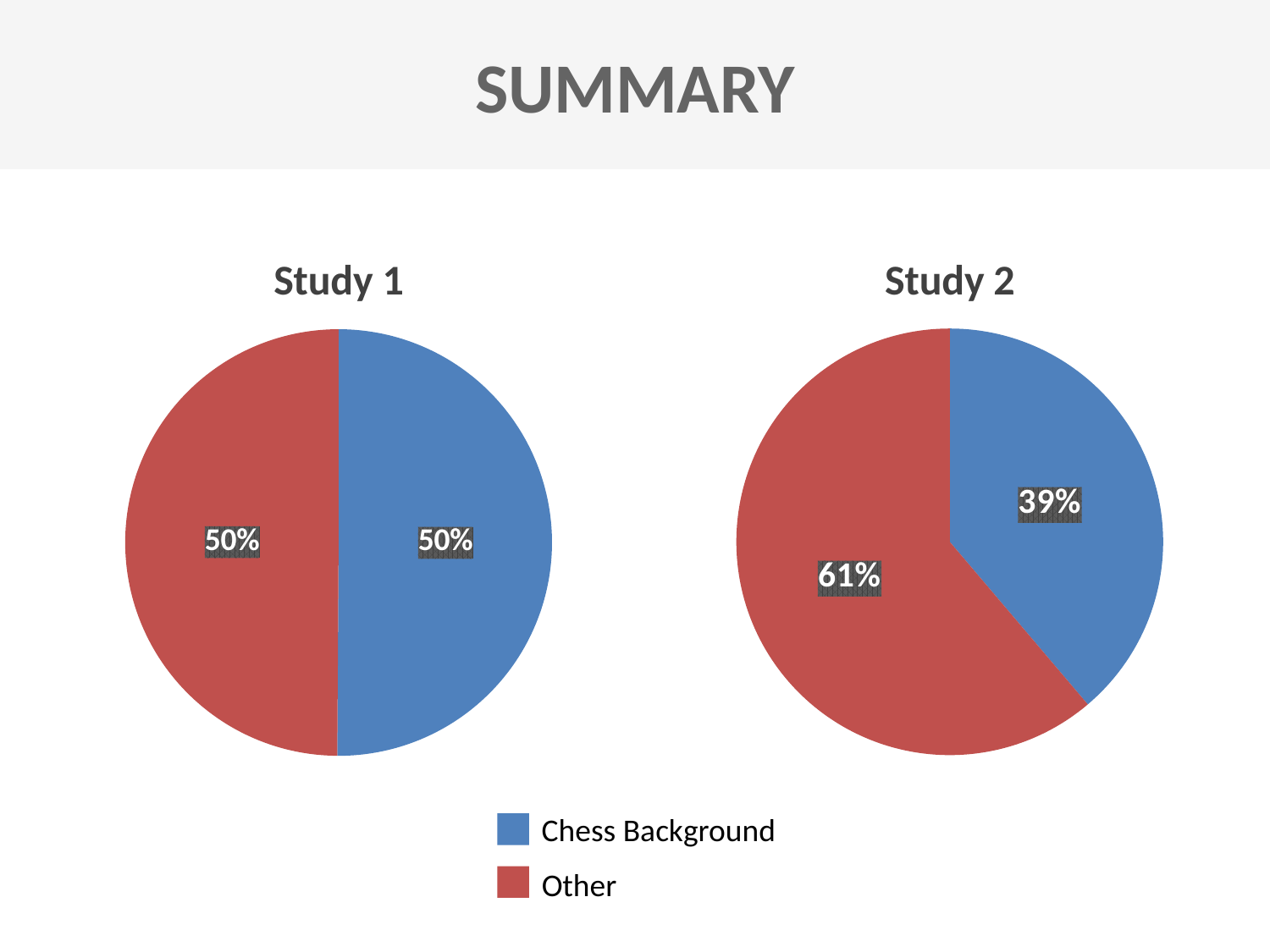
In the Study 2 chart, which slice is the smallest? Chess Background In the Study 2 chart, what is the difference between the Other share and the Chess Background share? 22% In the Study 2 chart, what share of the pie is Other? 61% In the Study 2 chart, what share of the pie is Chess Background? 39% In the Study 2 chart, which slice is the largest? Other How many slices does the Study 2 chart have? 2 What colour represents Chess Background in the charts? Blue In the Study 2 chart, which is larger, Chess Background or Other? Other What kind of chart is the Study 1 chart? Pie chart In the Study 1 chart, what share of the pie is Other? 50% How many entries does the legend list? 2